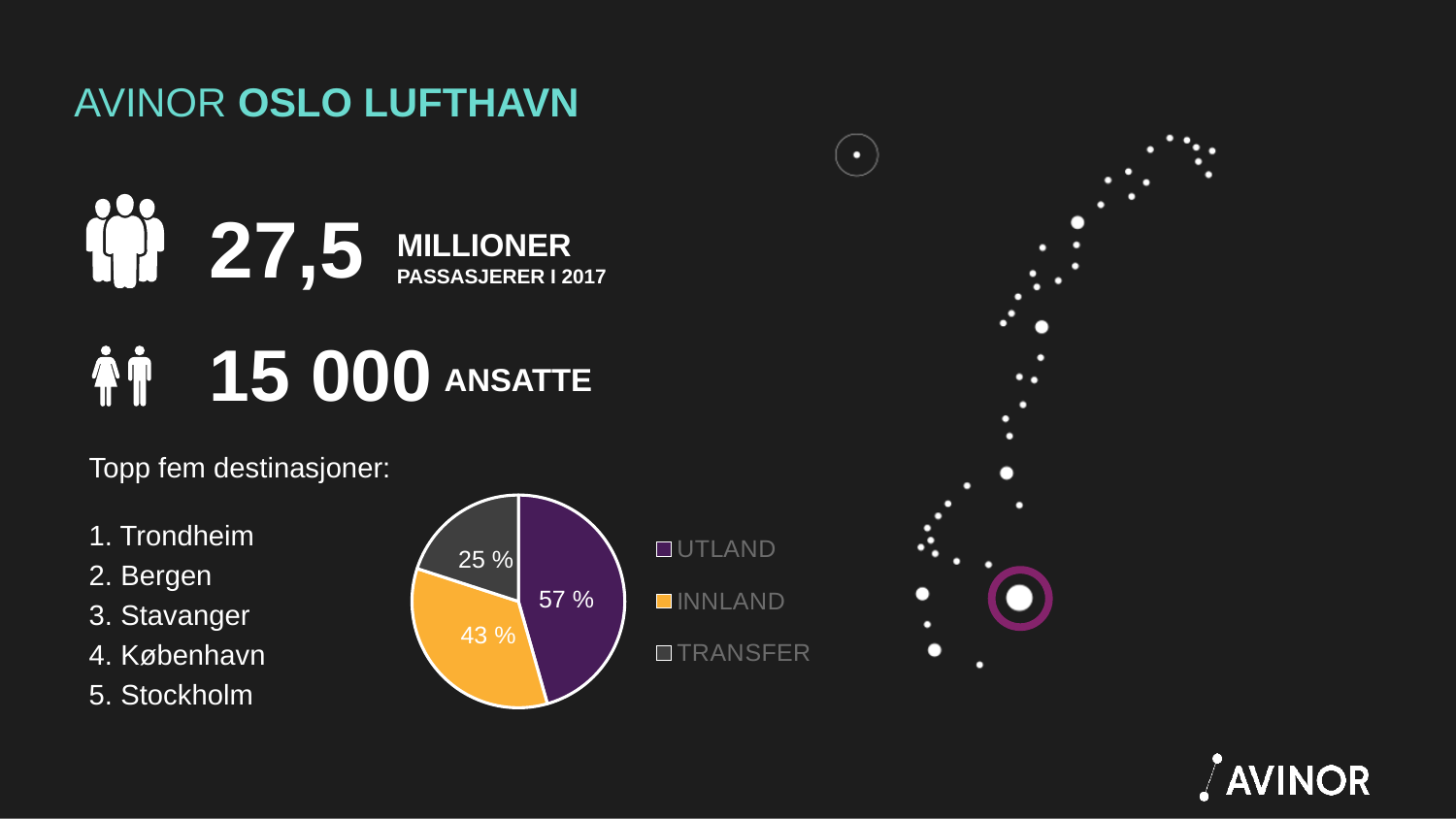
What kind of chart is shown on the slide? pie chart How many entries does the pie chart legend list? 3 What colour is the INNLAND slice in the pie chart? orange How many slices does the pie chart have? 3 Which is larger in the pie chart, UTLAND or INNLAND? UTLAND Which slice of the pie chart has the largest share? UTLAND What is the difference in percentage points between the UTLAND and INNLAND slices? 14 What percentage is shown for the INNLAND slice of the pie chart? 43 % What percentage is shown for the UTLAND slice of the pie chart? 57 % Which slice of the pie chart has the smallest share? TRANSFER What is the difference in percentage points between the INNLAND and TRANSFER slices? 18 What percentage is shown for the TRANSFER slice of the pie chart? 25 %